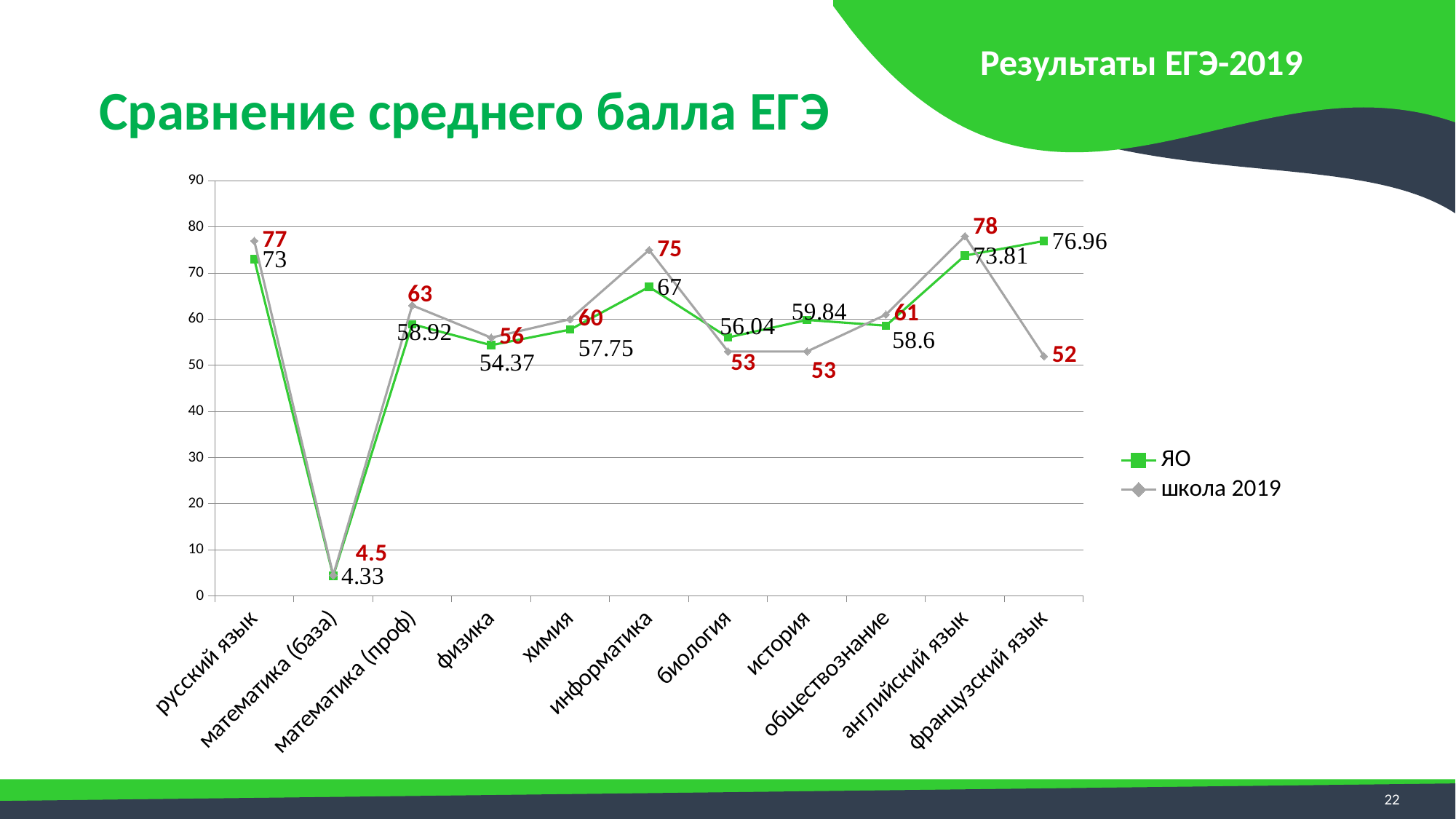
How many series does the legend list? 2 What is the value for школа 2019 for информатика? 75 Which subject has the lowest value for the ЯО series? математика (база) What kind of chart is shown on the slide? line chart How many subjects (categories) are plotted along the x axis? 11 What are the two series named in the legend? ЯО and школа 2019 What is the difference between школа 2019 and ЯО for информатика? 8 What is the value for ЯО for английский язык? 73.81 What is the value for школа 2019 for французский язык? 52 For французский язык, which series has the larger value, ЯО or школа 2019? ЯО What is the value for ЯО for русский язык? 73 Which subject has the highest value for the школа 2019 series? английский язык